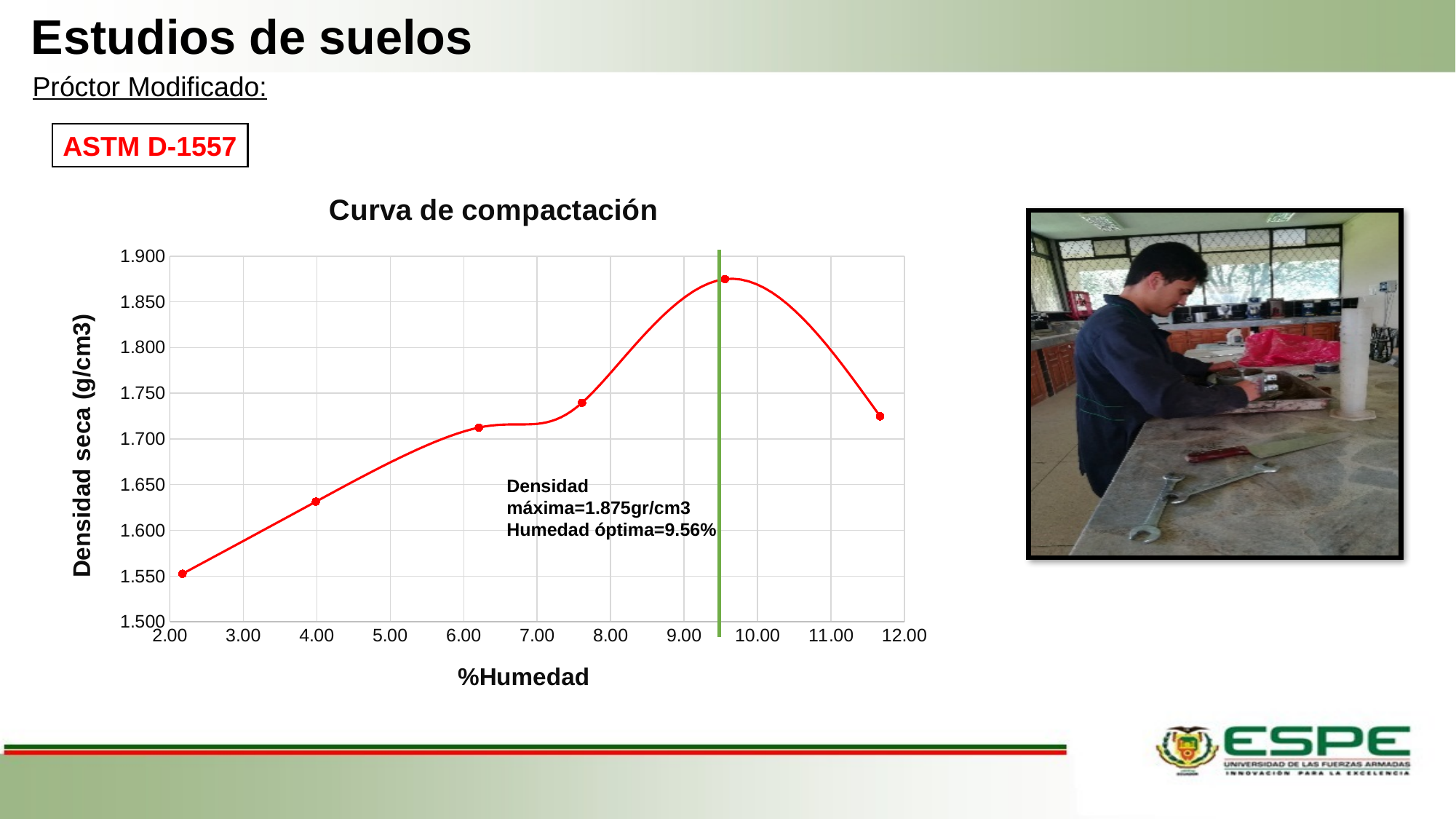
Does the dry density rise or fall as moisture increases from 2.00% up to the optimum of 9.56%? rise At what moisture content does the dry density reach its highest value? 9.56% What kind of chart is shown under the title 'Curva de compactación'? line chart How many data points are plotted on the compaction curve? 6 Is the dry density at 4.00% moisture greater or less than 1.700? less What is the maximum dry density (Densidad máxima) stated on the chart? 1.875gr/cm3 Is the lowest dry density found at the lowest or the highest moisture content plotted? lowest moisture content Is the dry density of the leftmost point (around 2.00% moisture) greater or less than 1.600? less Is the dry density of the rightmost point (around 11.70% moisture) greater or less than 1.800? less What is the label of the x axis of the chart? %Humedad What is the optimum moisture content (Humedad óptima) stated on the chart? 9.56% What is the title of the chart? Curva de compactación